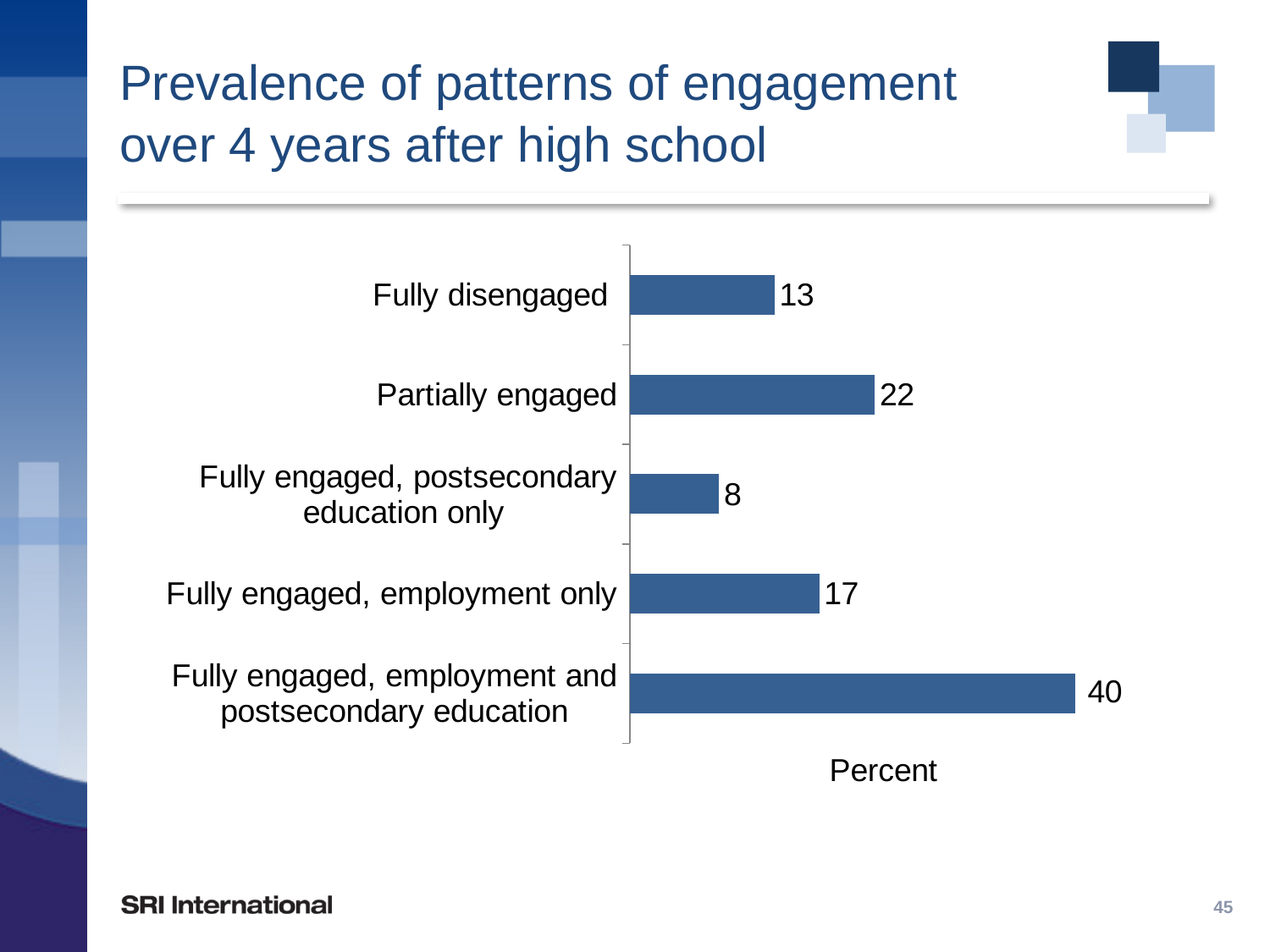
What is the difference between the values for Partially engaged and Fully disengaged? 9 What is the label on the horizontal axis of the chart? Percent What is the value for Fully engaged, postsecondary education only? 8 Which category has the lowest value? Fully engaged, postsecondary education only What is the value for Fully engaged, employment and postsecondary education? 40 How many categories are shown in the chart? 5 Which category has the highest value? Fully engaged, employment and postsecondary education What kind of chart is shown on the slide? Bar chart What is the value for Fully engaged, employment only? 17 Which is larger, the value for Fully engaged, employment only or the value for Partially engaged? Partially engaged What is the value for Fully disengaged? 13 What is the value for Partially engaged? 22